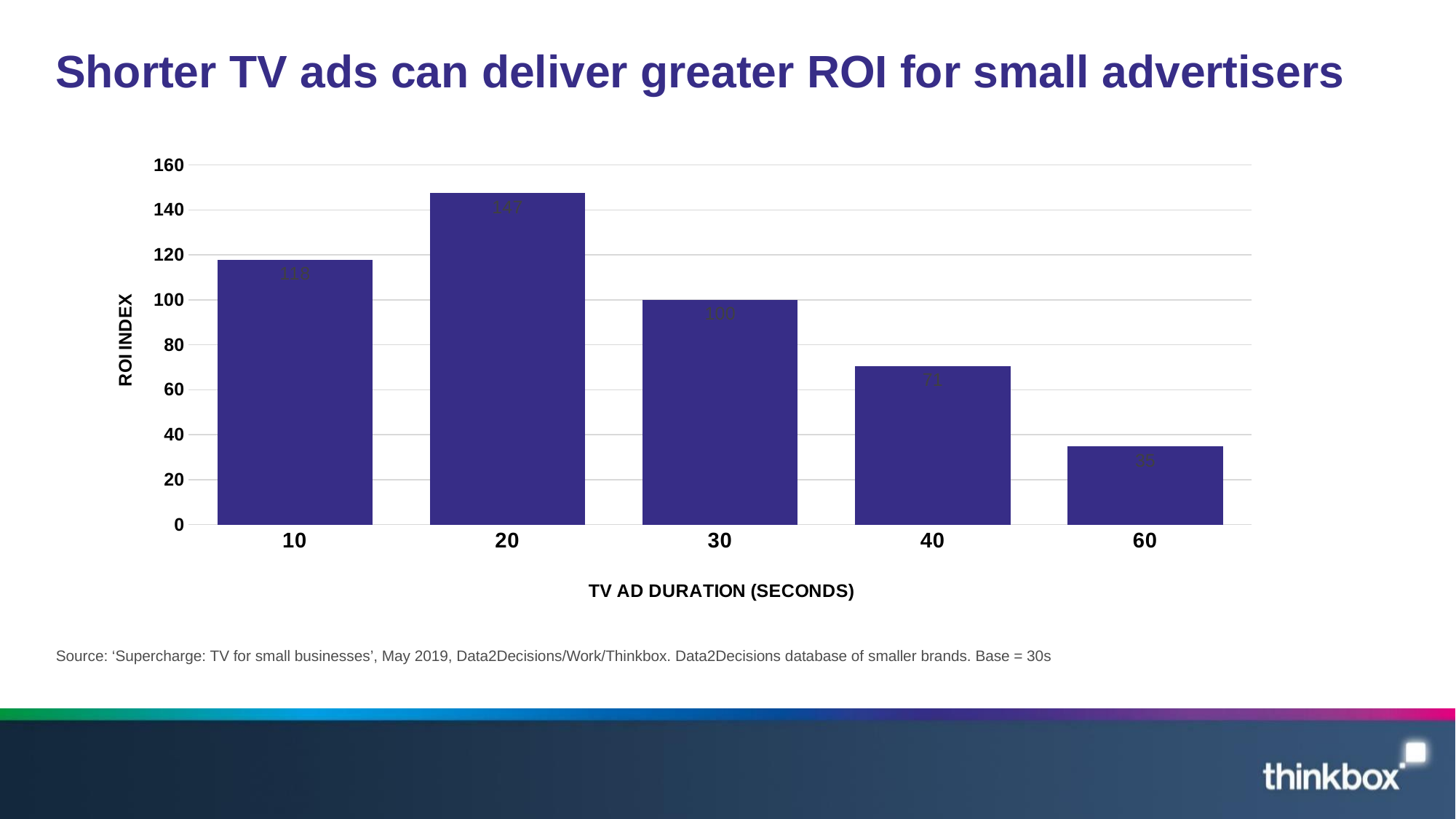
What is the ROI index for a 20-second TV ad? 147 What is the label of the horizontal axis? TV AD DURATION (SECONDS) Which TV ad duration has the highest ROI index? 20 What is the ROI index for a 60-second TV ad? 35 What is the ROI index for a 10-second TV ad? 118 What is the label of the vertical axis? ROI INDEX How many TV ad durations are shown on the chart? 5 What is the difference in ROI index between the 20-second and 30-second ads? 47 Is the ROI index for the 40-second ad greater or less than 80? less What type of chart is shown on the slide? bar chart Which has a higher ROI index, the 10-second ad or the 40-second ad? 10 Which TV ad duration has the lowest ROI index? 60